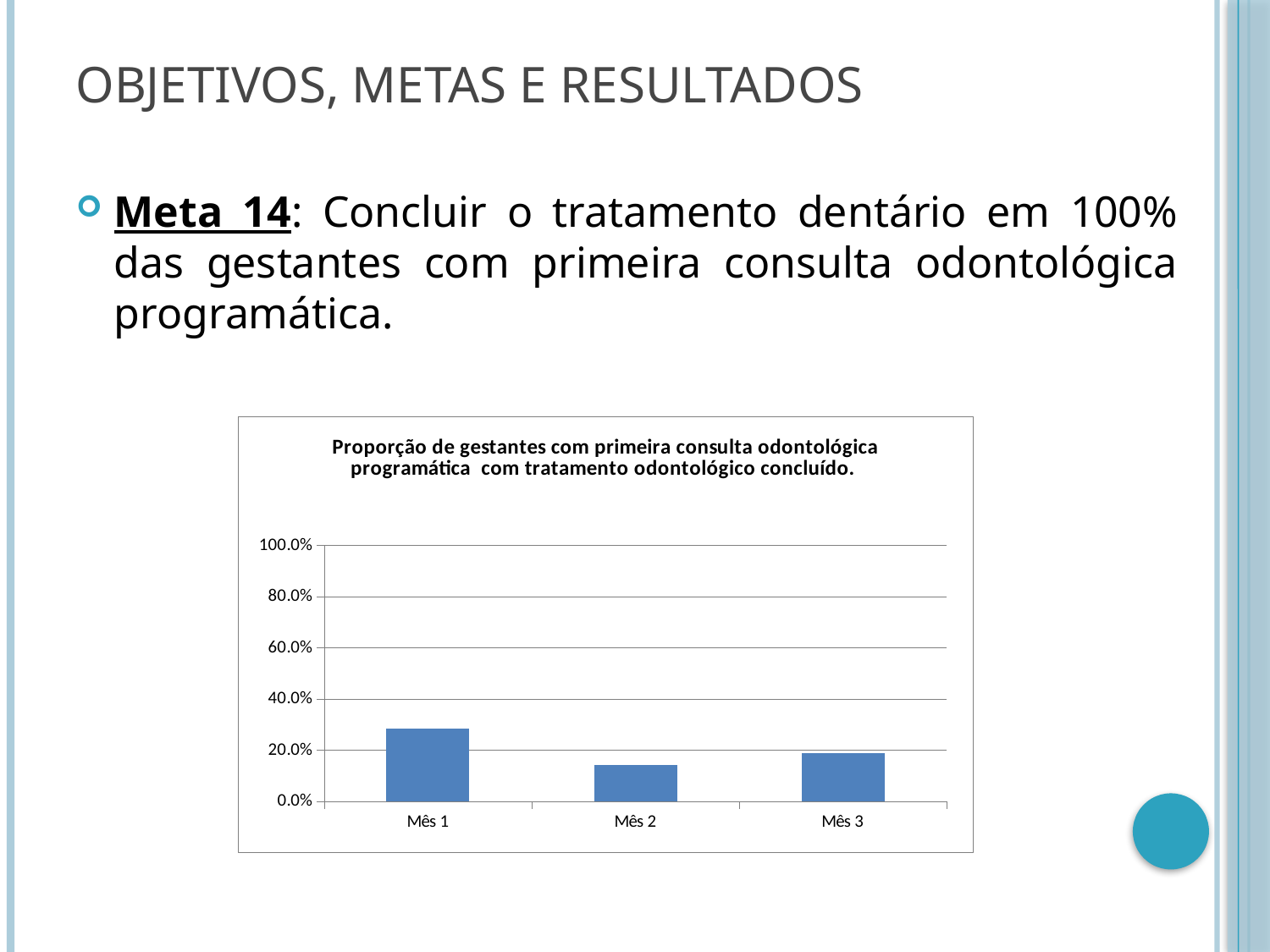
Is the value for Mês 2 greater or less than 20.0%? less Which is larger, the value for Mês 2 or the value for Mês 3? Mês 3 What is the highest tick value shown on the y axis of the chart? 100.0% Does the value rise or fall from Mês 1 to Mês 2? fall What kind of chart is shown on the slide? bar chart Which month has the lowest value in the chart? Mês 2 Is the value for Mês 1 greater or less than 20.0%? greater Is the value for Mês 1 greater or less than 40.0%? less Which is larger, the value for Mês 1 or the value for Mês 3? Mês 1 Which month has the highest value in the chart? Mês 1 How many categories (months) are shown on the x axis of the chart? 3